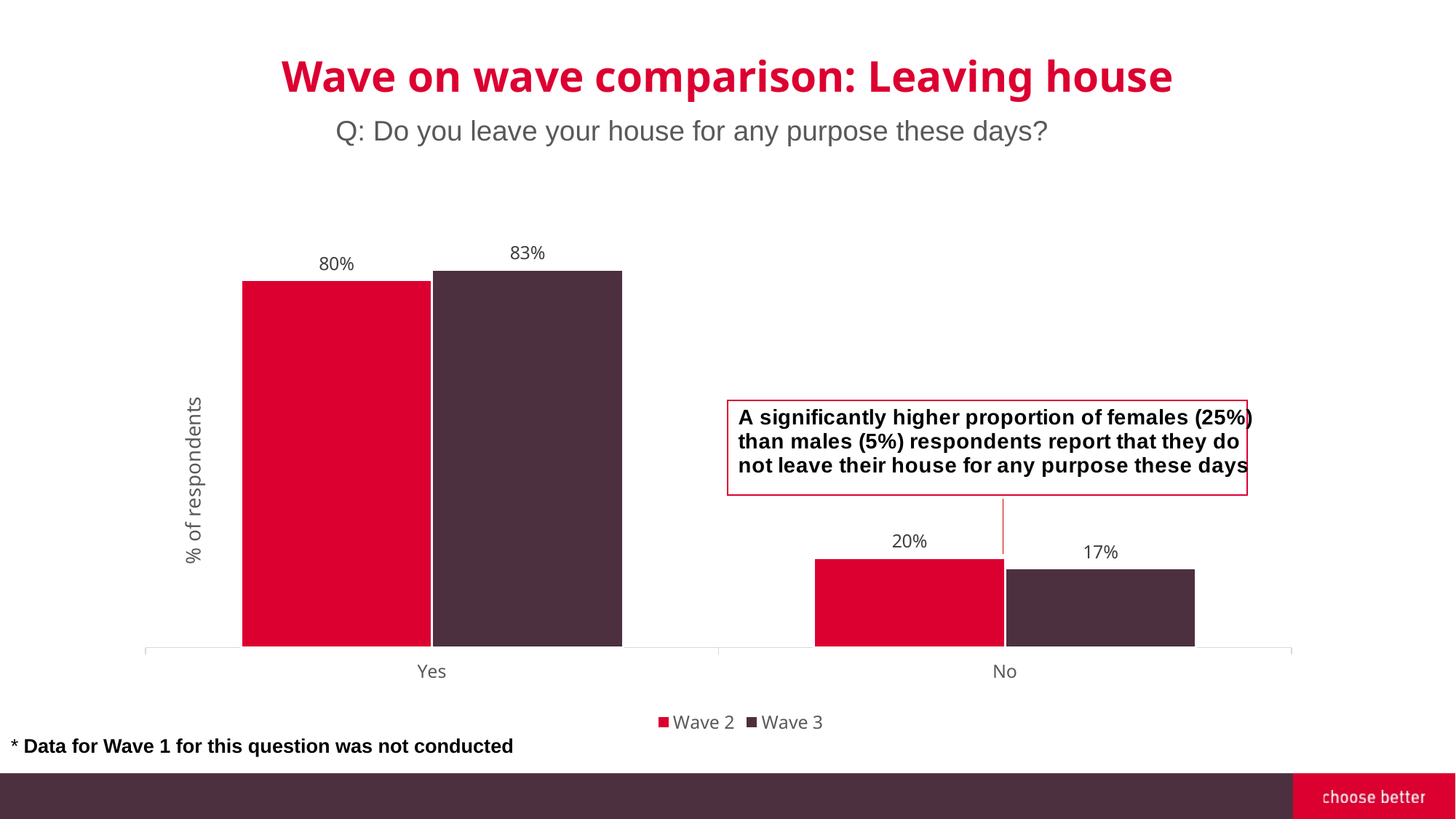
Which bar has the highest value on the chart? Wave 3, Yes Which bar has the lowest value on the chart? Wave 3, No What is the difference between the Wave 3 and Wave 2 values for Yes? 3% What percentage of respondents answered Yes in Wave 3? 83% What percentage of respondents answered No in Wave 2? 20% What is the difference between the Wave 2 and Wave 3 values for No? 3% What percentage of respondents answered No in Wave 3? 17% How many categories are shown on the x axis? 2 What percentage of respondents answered Yes in Wave 2? 80% How many series does the legend list? 2 Which is larger for the No category: Wave 2 or Wave 3? Wave 2 What kind of chart is shown on the slide? Bar chart